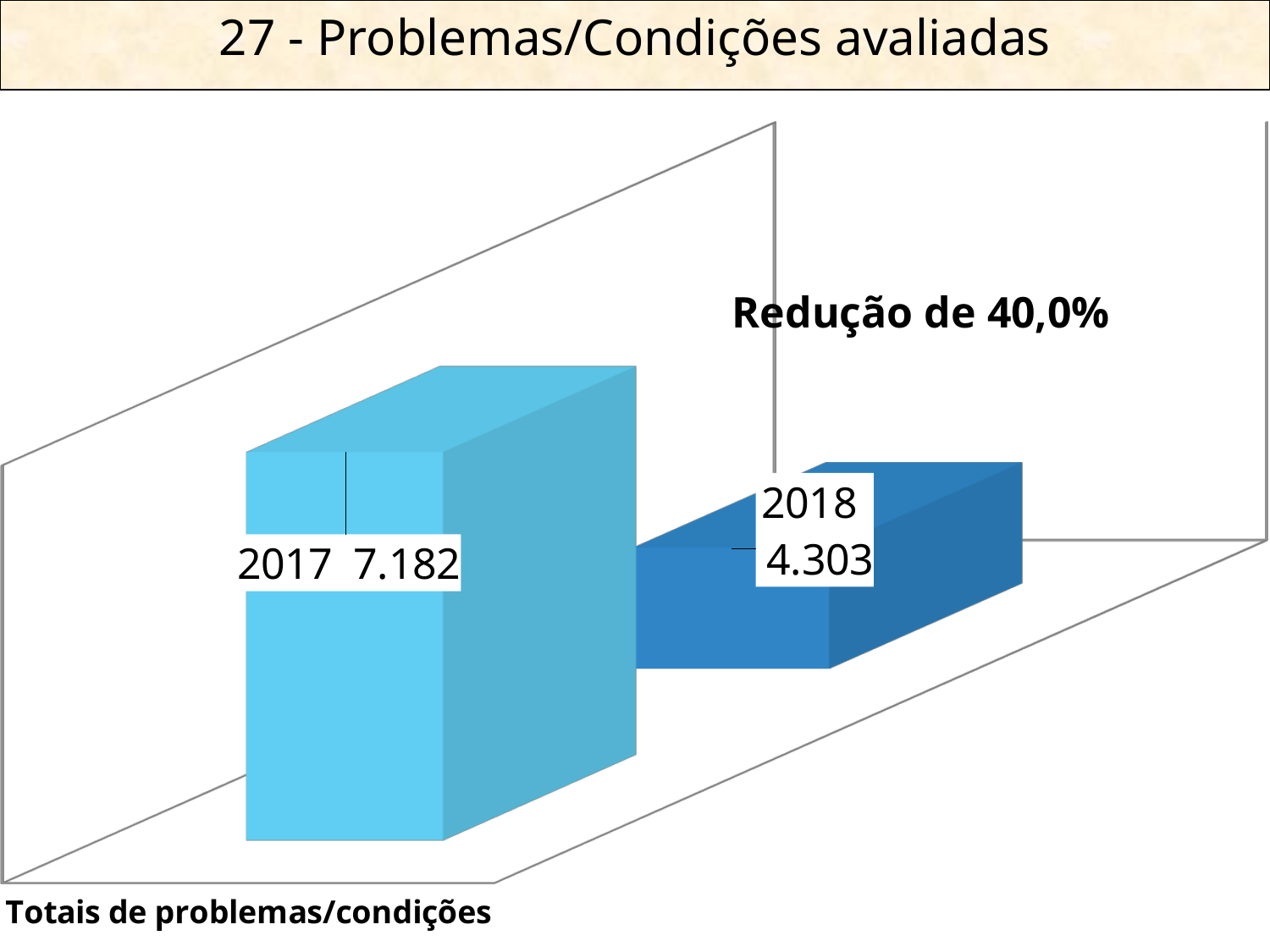
What is the combined total of the values for 2017 and 2018? 11.485 What percentage reduction is stated on the slide? 40,0% Which is larger, the value for 2017 or the value for 2018? 2017 Do the values rise or fall from 2017 to 2018? Fall Which year has the lowest value? 2018 What is the value for 2018? 4.303 What kind of chart is shown on the slide? Bar chart Which year has the highest value? 2017 What is the difference between the values for 2017 and 2018? 2.879 How many bars are plotted in the chart? 2 What is the value for 2017? 7.182 What is the title of the slide? 27 - Problemas/Condições avaliadas